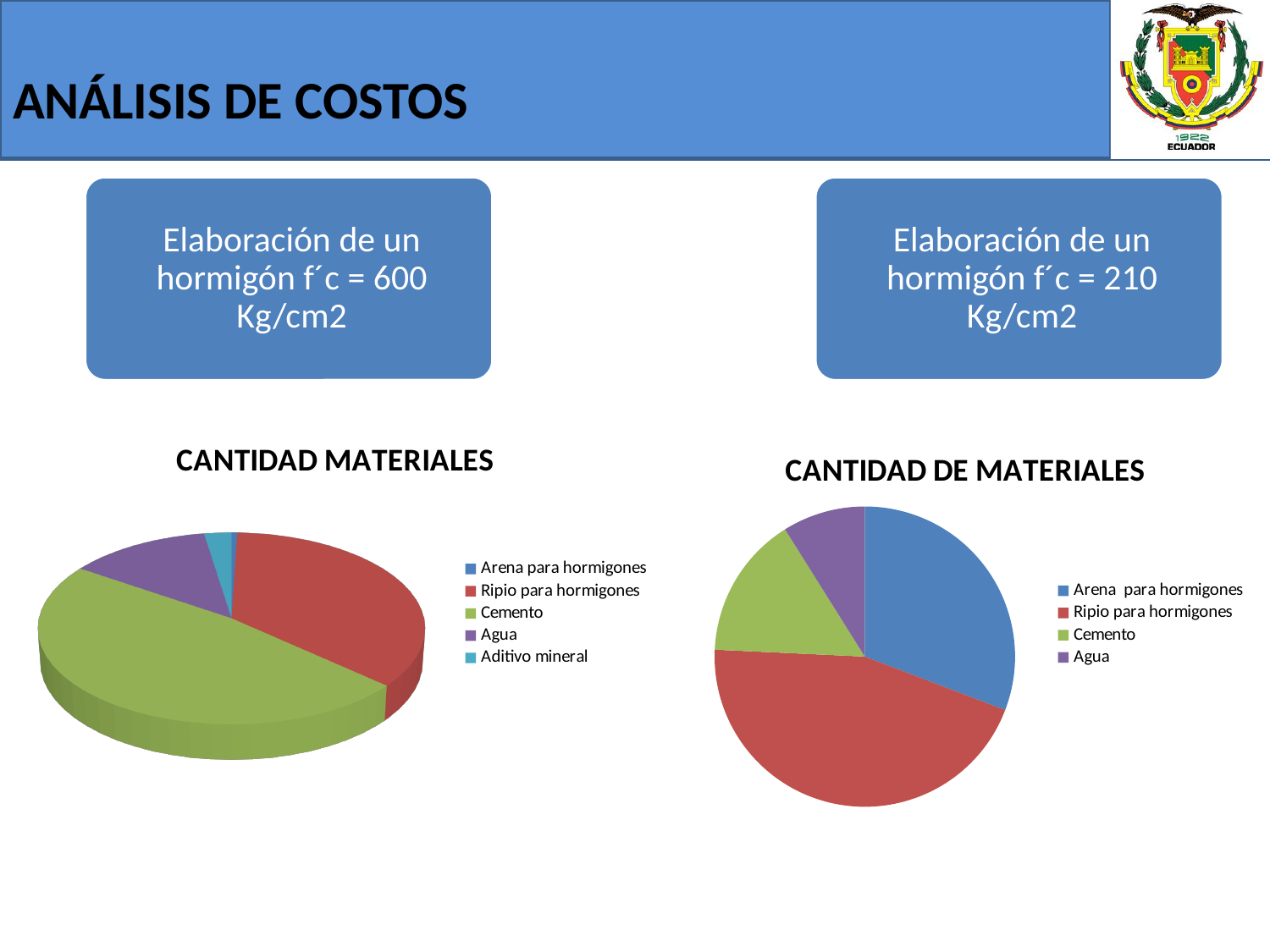
What kind of chart is the right chart titled "CANTIDAD DE MATERIALES"? pie chart In the right chart "CANTIDAD DE MATERIALES", what colour is the slice for Cemento? green What kind of chart is the left chart titled "CANTIDAD MATERIALES"? pie chart In the right chart "CANTIDAD DE MATERIALES", which slice is larger: Ripio para hormigones or Agua? Ripio para hormigones In the left chart "CANTIDAD MATERIALES", which material has the largest slice? Cemento In the right chart "CANTIDAD DE MATERIALES", which slice is larger: Arena para hormigones or Cemento? Arena para hormigones In the right chart "CANTIDAD DE MATERIALES", which material has the smallest slice? Agua In the right chart "CANTIDAD DE MATERIALES", which material has the largest slice? Ripio para hormigones In the right chart "CANTIDAD DE MATERIALES", how many entries does the legend list? 4 Which legend entry appears in the left chart "CANTIDAD MATERIALES" but not in the right chart "CANTIDAD DE MATERIALES"? Aditivo mineral In the left chart "CANTIDAD MATERIALES", how many entries does the legend list? 5 In the left chart "CANTIDAD MATERIALES", which slice is larger: Cemento or Agua? Cemento